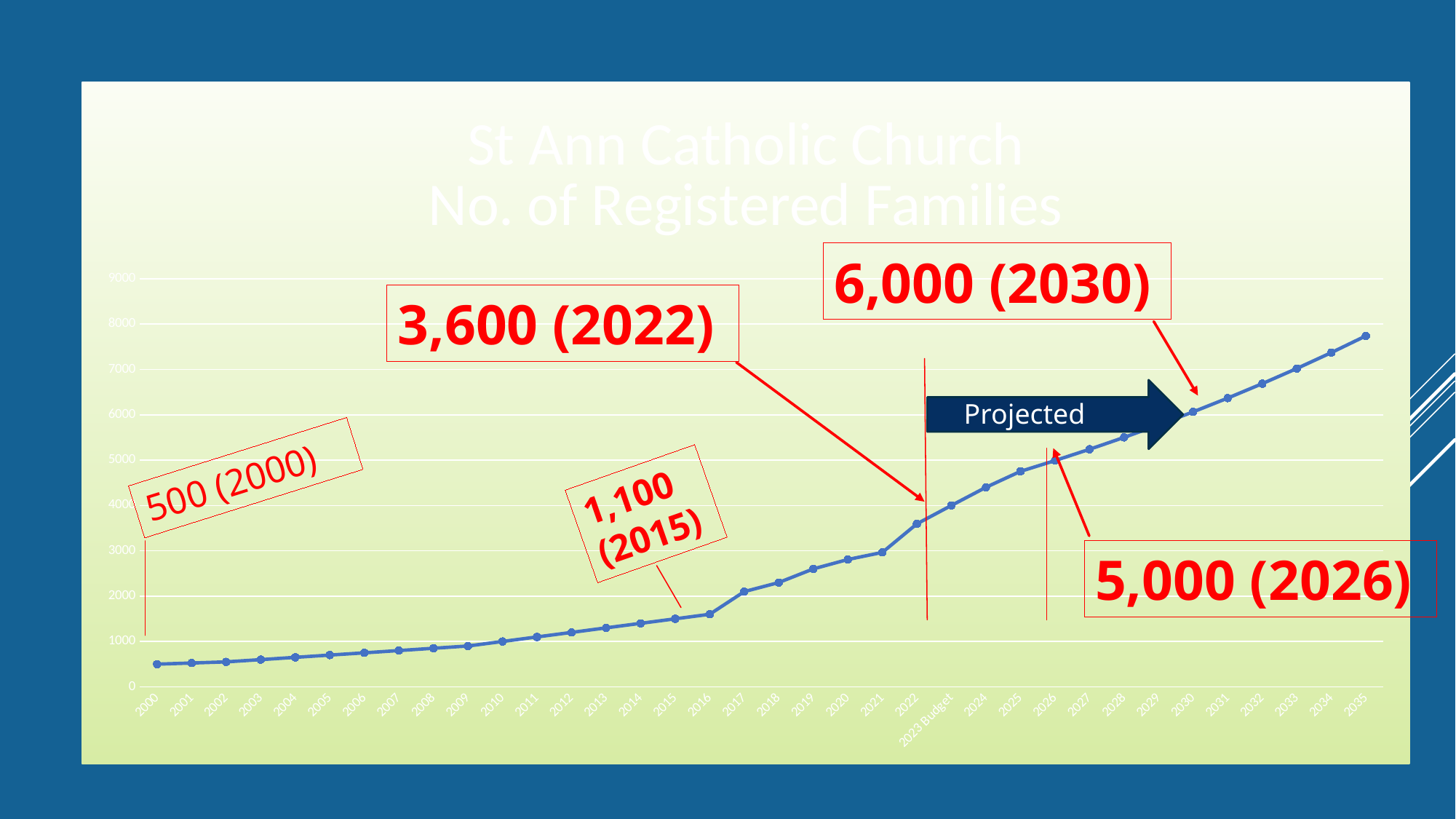
Do the values rise or fall from 2000 to 2035? Rise What value is labelled for 2022? 3,600 What is the title of the chart? St Ann Catholic Church No. of Registered Families What is the difference between the labelled values for 2030 and 2022? 2,400 Is the value for 2035 greater or less than 7000? greater What value is labelled for 2015? 1,100 What is the difference between the labelled values for 2026 and 2022? 1,400 Which year has the lowest number of registered families? 2000 What value is labelled for 2030? 6,000 What type of chart is shown on the slide? Line chart What value is labelled for 2026? 5,000 How many registered families are labelled for the year 2000? 500